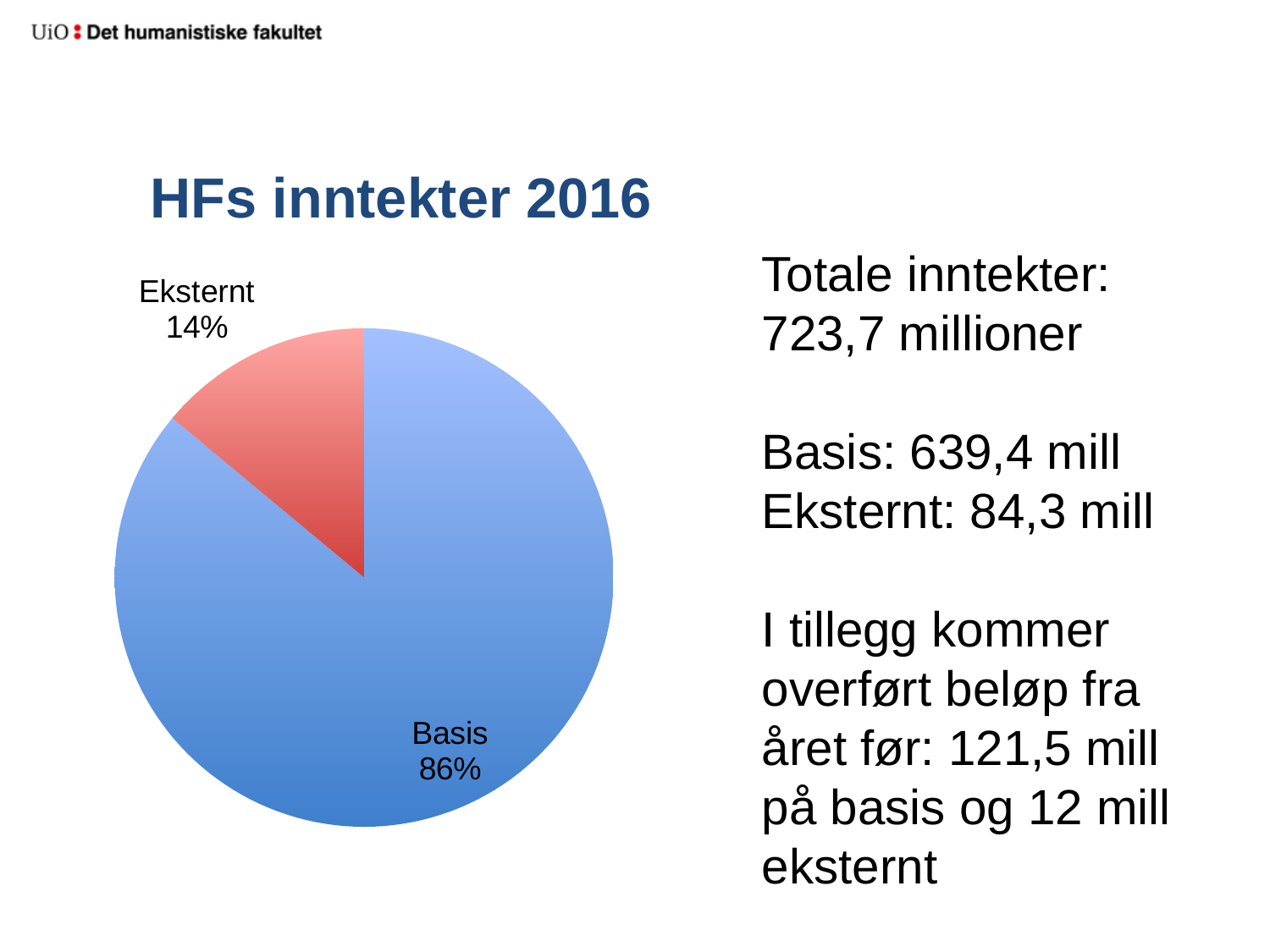
What is the title of the slide containing the pie chart? HFs inntekter 2016 How many slices does the pie chart have? 2 What share of the pie does Eksternt represent? 14% Is the share for Eksternt greater or less than 50%? less Which slice of the pie is the largest? Basis Which is larger, the Basis slice or the Eksternt slice? Basis What kind of chart is shown on the slide? pie chart Which slice of the pie is the smallest? Eksternt What share of the pie does Basis represent? 86% What colour is the Eksternt slice of the pie? red What is the difference in percentage points between the Basis and Eksternt slices? 72